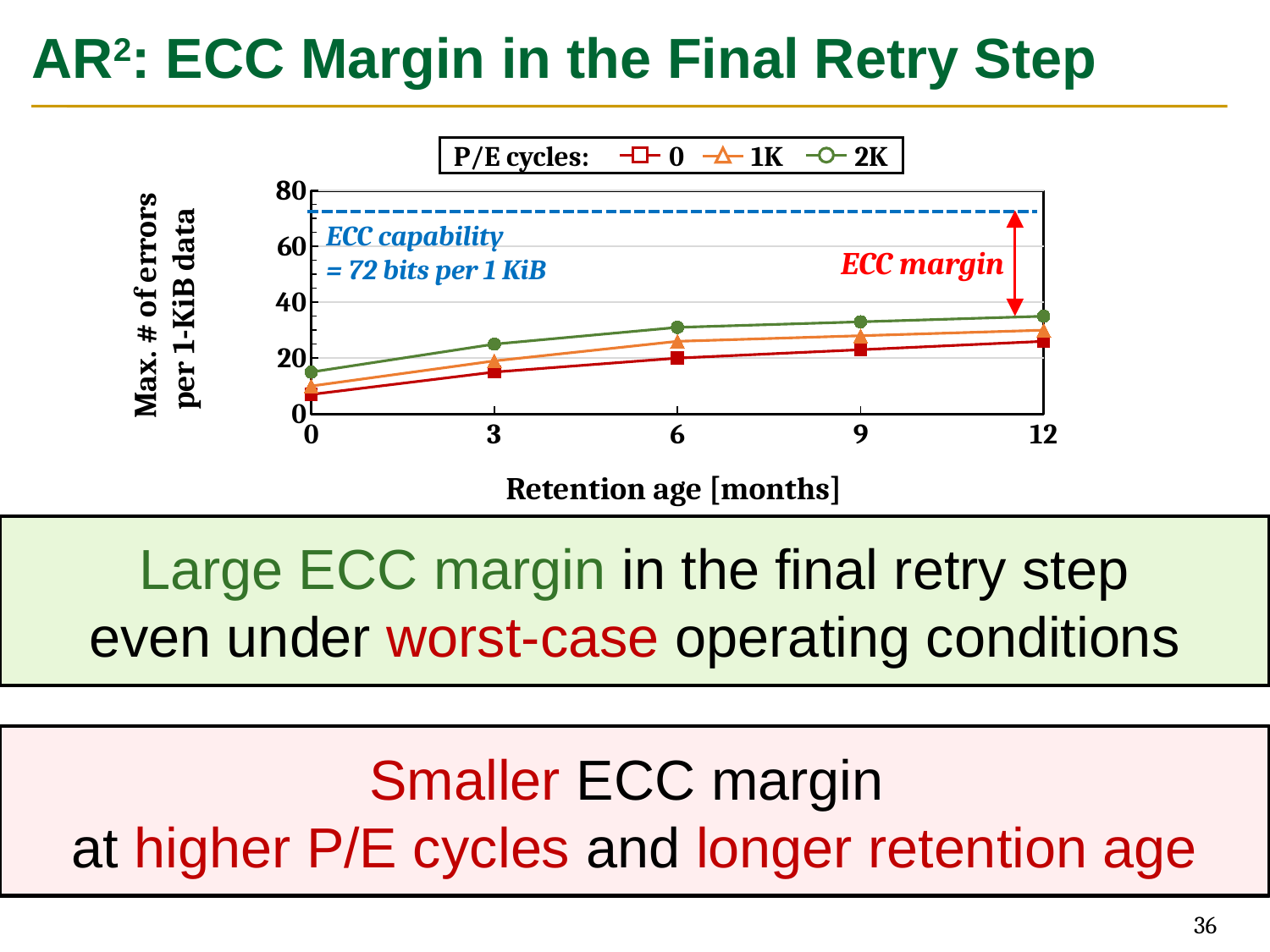
Is the value for the 2K series at 12 months greater or less than 40? less What is the label of the x axis? Retention age [months] Which P/E cycles series has the lowest value at 0 months of retention age? 0 How many series does the legend list? 3 What kind of chart is shown on the slide? line chart At 3 months of retention age, which is larger: the value for the 2K series or the value for the 0 series? 2K How many retention-age points are plotted for each series? 5 Which P/E cycles series has the highest value at 12 months of retention age? 2K Is the value for the 0 series at 0 months greater or less than 20? less What ECC capability does the dashed line on the chart represent? 72 bits per 1 KiB Is the value for the 2K series at 6 months greater or less than 20? greater Do the values for the 2K P/E cycles series rise or fall as retention age increases? rise